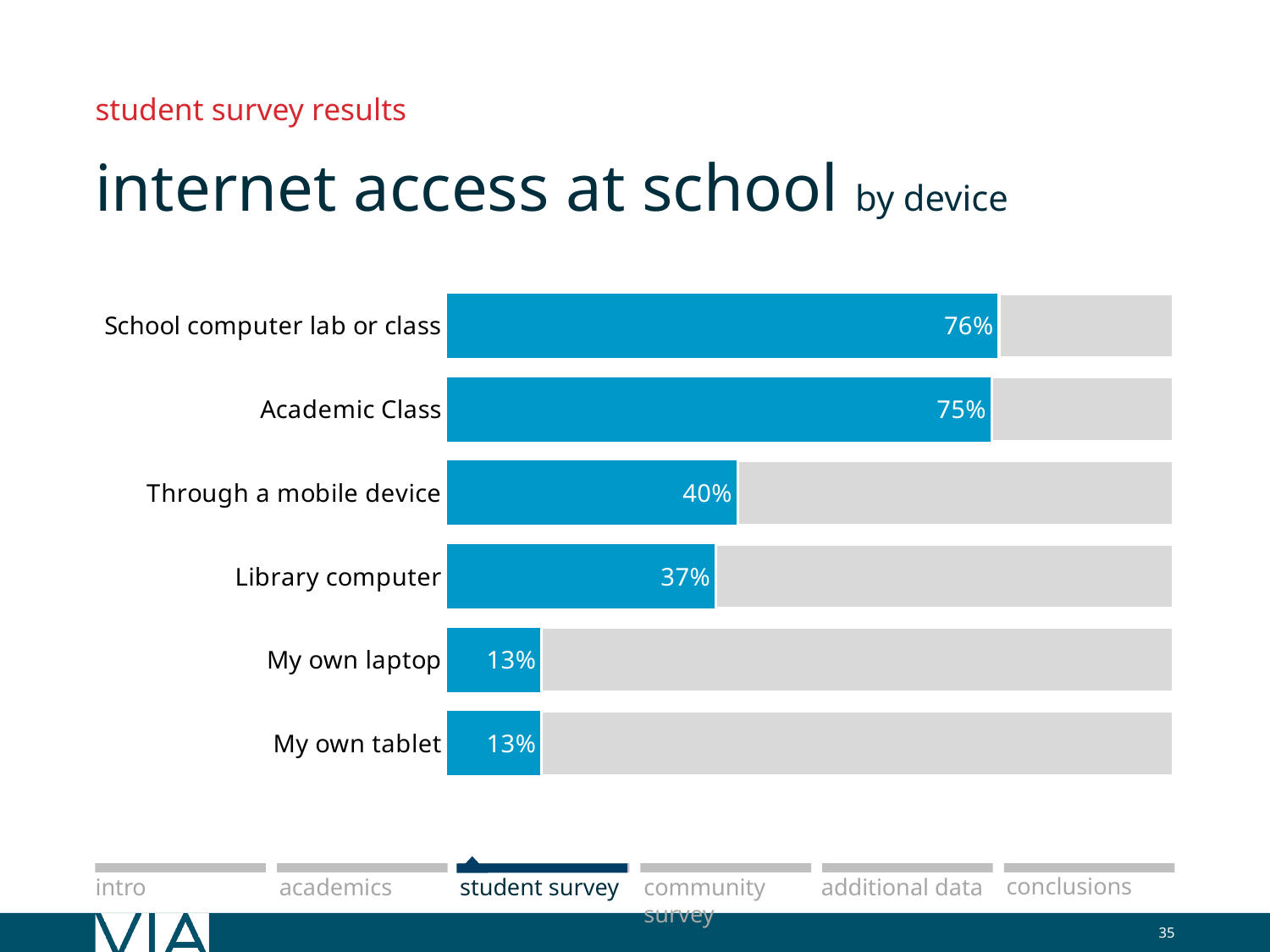
What percentage of students access the internet at school through a school computer lab or class? 76% How many categories are shown in the chart? 6 What is the value for Through a mobile device? 40% Which category has the highest value? School computer lab or class What kind of chart is shown on the slide? Bar chart What is the value for Library computer? 37% What is the difference between the values for Academic Class and Through a mobile device? 35% Which two categories share the same value of 13%? My own laptop and My own tablet What is the value for My own tablet? 13% Which is larger, the value for Through a mobile device or the value for Library computer? Through a mobile device What is the difference between the values for Library computer and My own laptop? 24% What is the title of the slide containing the chart? internet access at school by device